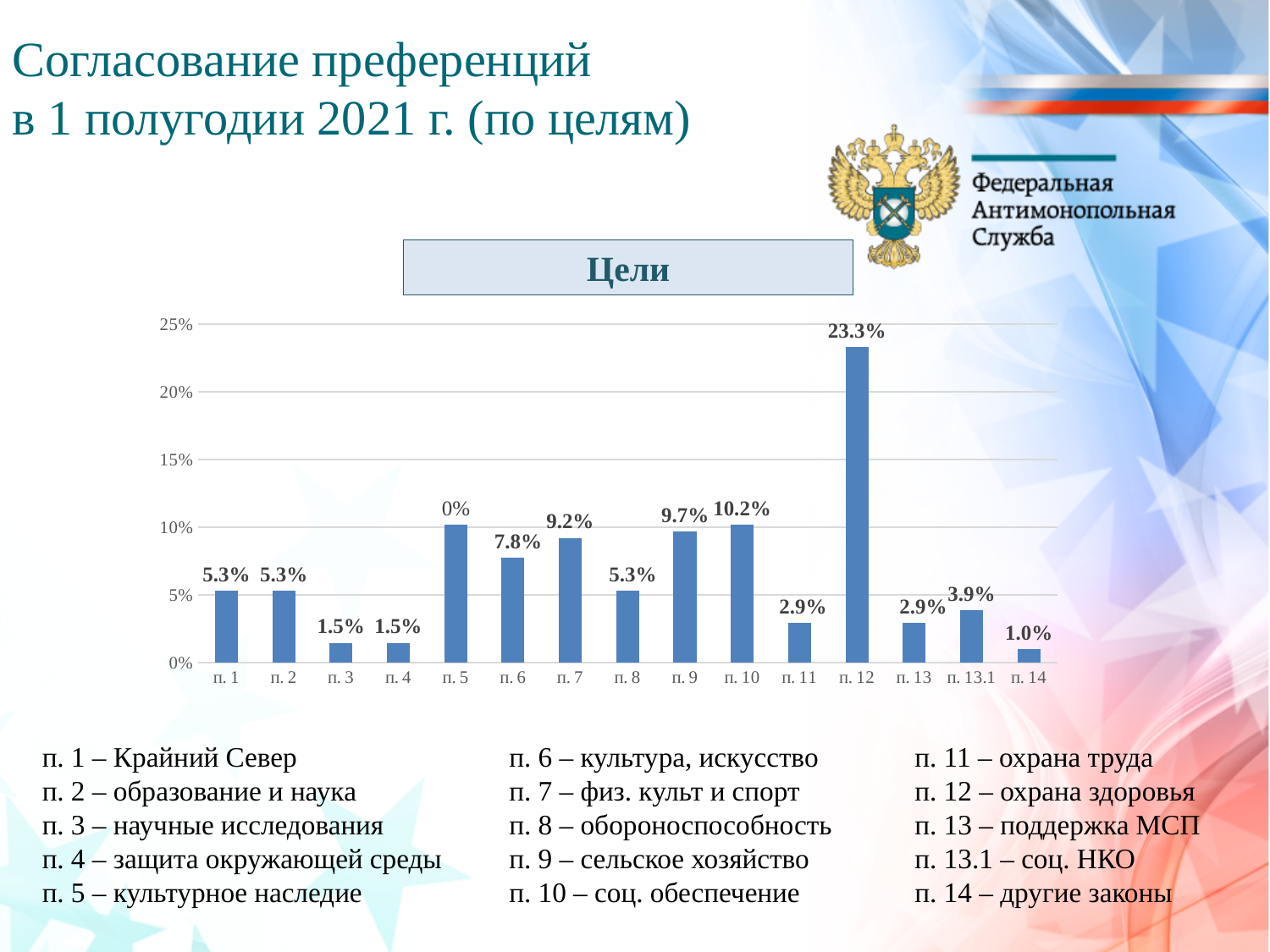
Which is larger, the value for п. 9 or the value for п. 7? п. 9 Is the value for п. 12 greater or less than 20%? greater What is the title of the chart? Цели What is the value for п. 3? 1.5% What is the value for п. 12? 23.3% What is the value for п. 10? 10.2% What is the difference between the values for п. 6 and п. 3? 6.3% How many categories are plotted on the x axis of the chart? 15 What is the value for п. 13.1? 3.9% What type of chart is shown on the slide? bar chart Which category has the highest value? п. 12 What is the difference between the values for п. 12 and п. 10? 13.1%